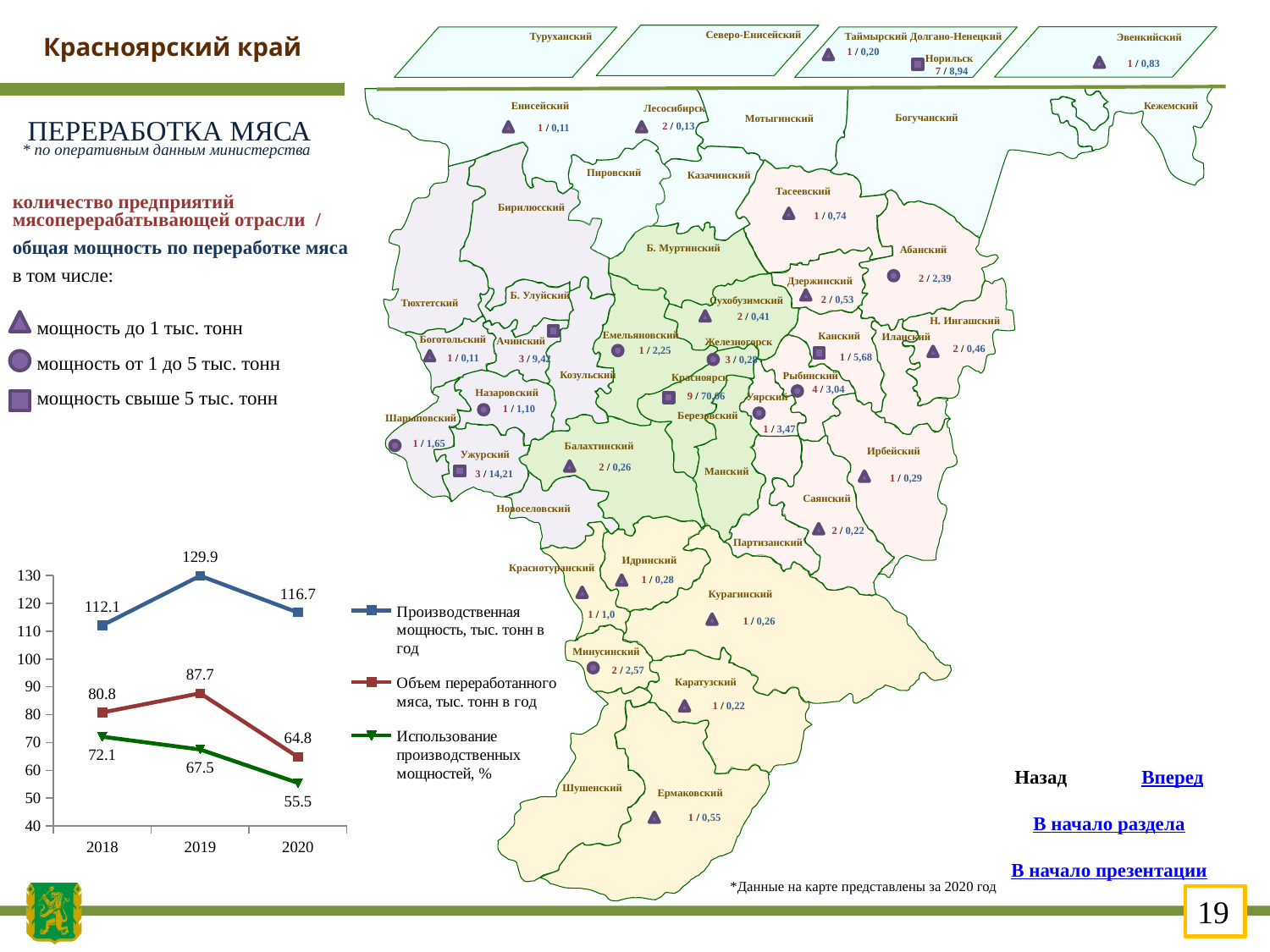
In which year is 'Производственная мощность, тыс. тонн в год' highest? 2019 Which is larger: 'Производственная мощность' in 2018 or in 2020? 2020 What is the value of 'Производственная мощность, тыс. тонн в год' in 2019? 129.9 Does 'Использование производственных мощностей, %' rise or fall from 2018 to 2020? fall What type of chart is shown in the lower-left of the slide? line chart What is the value of 'Объем переработанного мяса, тыс. тонн в год' in 2020? 64.8 What colour is the line for 'Объем переработанного мяса, тыс. тонн в год'? red What is the difference between 'Объем переработанного мяса' in 2019 and in 2020? 22.9 How many series does the legend of the line chart list? 3 What is the value of 'Использование производственных мощностей, %' in 2018? 72.1 How many years are shown on the x axis of the line chart? 3 In which year is 'Использование производственных мощностей, %' lowest? 2020